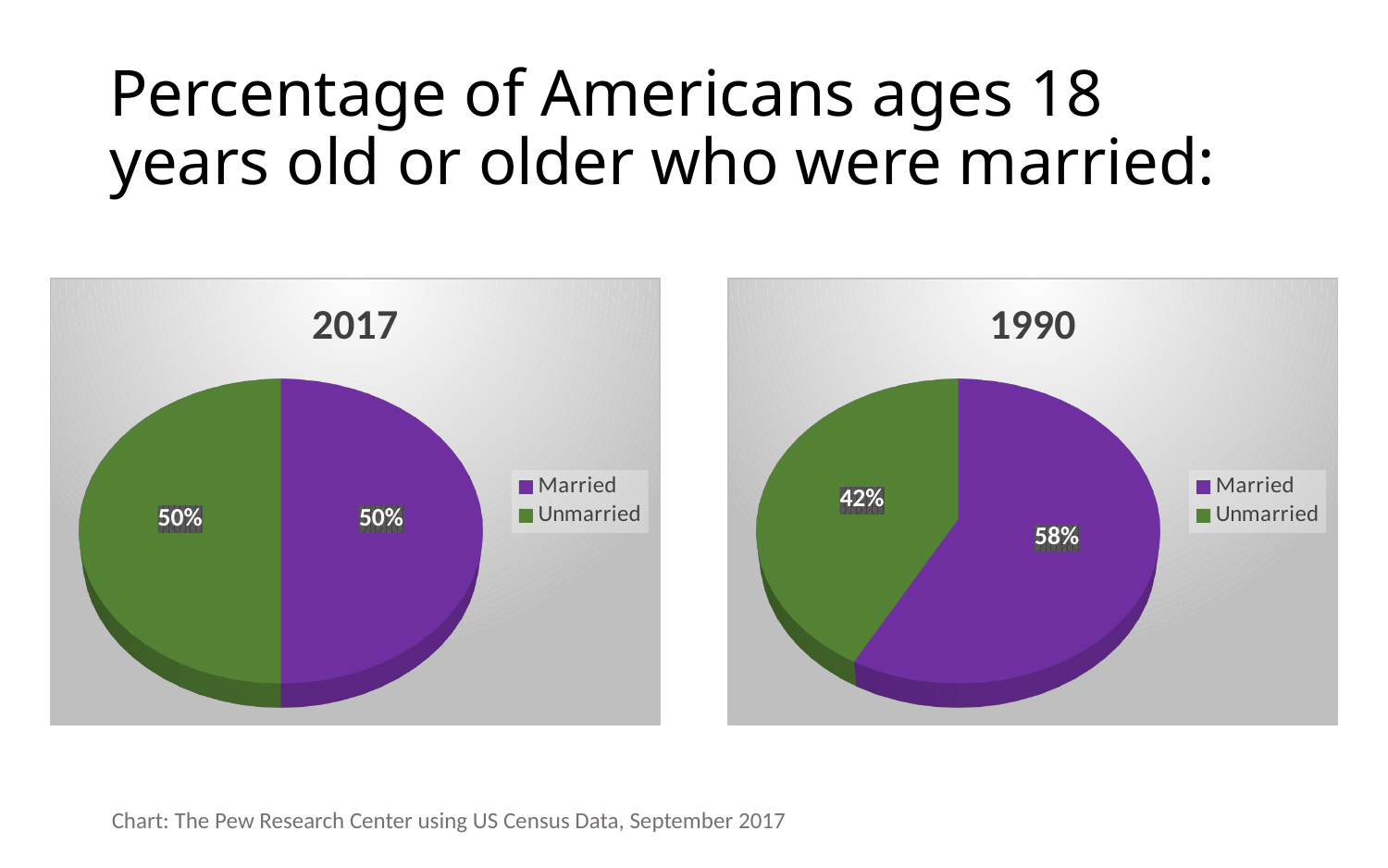
In the 2017 chart, what percentage is shown for Unmarried? 50% How many slices does the 1990 chart have? 2 How many entries does the legend of the 2017 chart list? 2 In the 1990 chart, what percentage is shown for Married? 58% In the 1990 chart, which slice is the smallest? Unmarried In the 1990 chart, is the Married slice larger or smaller than the Unmarried slice? larger In the 1990 chart, what percentage is shown for Unmarried? 42% What kind of chart is the 2017 chart? pie chart In the 2017 chart, what percentage is shown for Married? 50% In the 2017 chart, what colour is the Married slice? purple In the 1990 chart, what is the difference between the Married and Unmarried percentages? 16% In the 1990 chart, which slice is the largest? Married